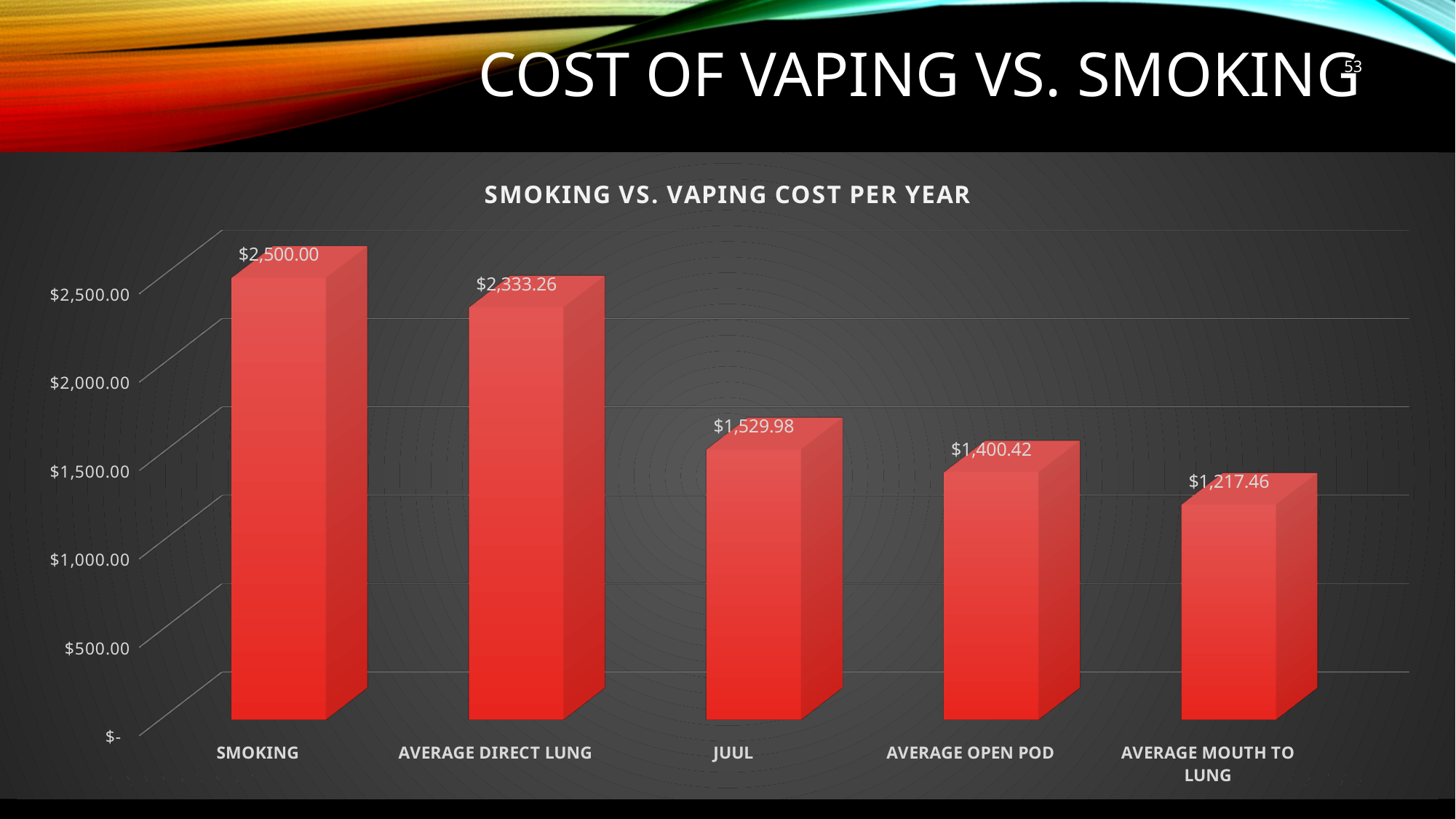
Which category has the lowest cost per year? Average Mouth to Lung Which category has the highest cost per year? Smoking What is the cost per year for Smoking? $2,500.00 What is the difference between the cost for JUUL and the cost for Average Open Pod? $129.56 How many categories are shown in the chart? 5 Do the values rise or fall from left to right across the categories? Fall What is the cost per year for Average Mouth to Lung? $1,217.46 What kind of chart is shown on the slide? Bar chart What is the difference between the cost for Smoking and the cost for Average Direct Lung? $166.74 What is the cost per year for Average Open Pod? $1,400.42 Which has a higher cost per year, Average Direct Lung or JUUL? Average Direct Lung What is the cost per year for JUUL? $1,529.98